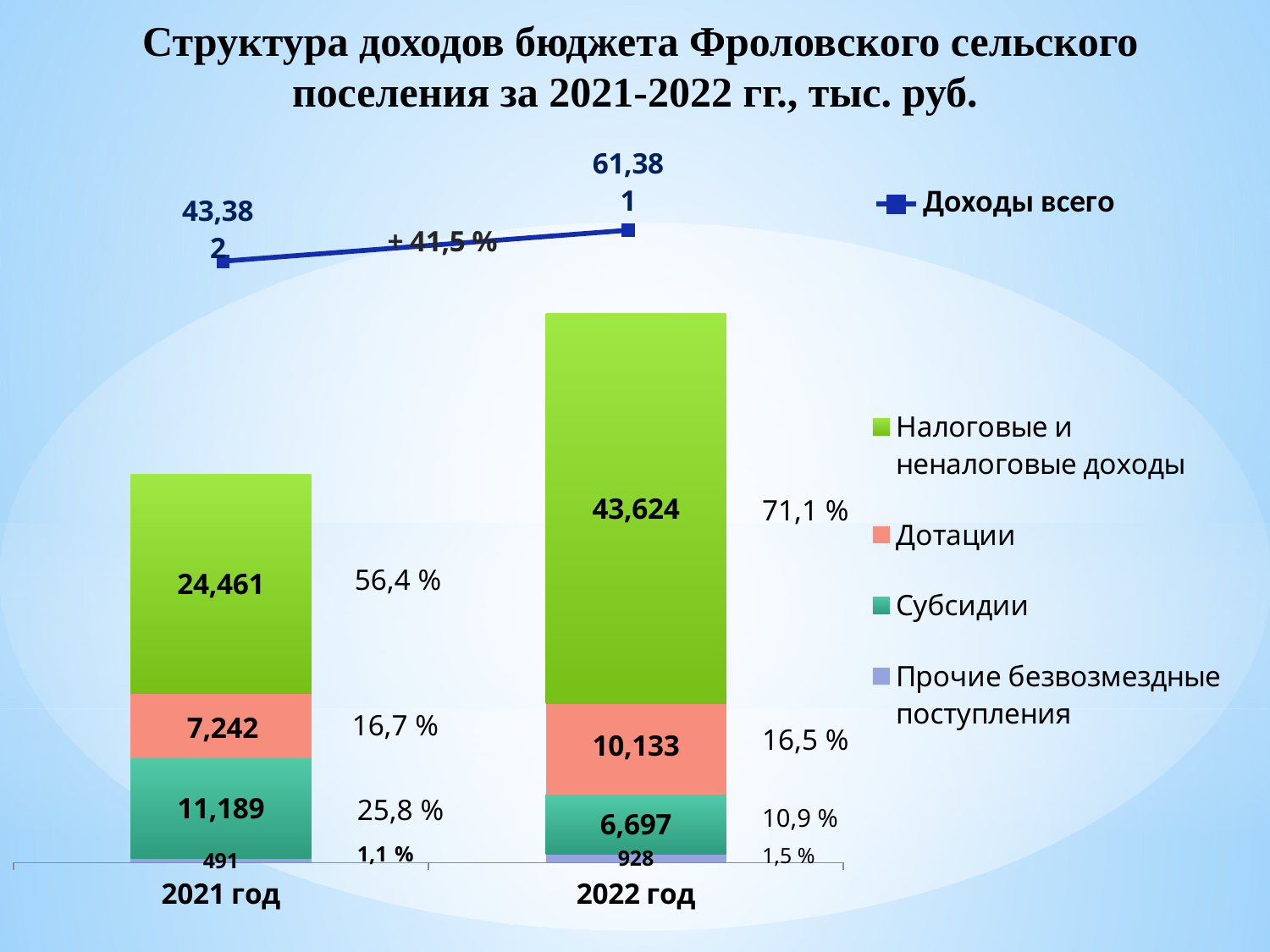
What is the value of Дотации for 2022 год? 10,133 By how much did Налоговые и неналоговые доходы increase from 2021 год to 2022 год? 19,163 Which component is the largest in the 2021 год bar? Налоговые и неналоговые доходы What percentage share is shown for Налоговые и неналоговые доходы in 2022 год? 71,1 % Is the value of Субсидии larger in 2021 год or in 2022 год? 2021 год What is the value of Субсидии for 2021 год? 11,189 How many years are shown on the x axis? 2 What is the value of Прочие безвозмездные поступления for 2022 год? 928 What percentage share is shown for Субсидии in 2021 год? 25,8 % Which component is the smallest in the 2022 год bar? Прочие безвозмездные поступления What is the value of Налоговые и неналоговые доходы for 2022 год? 43,624 What is the value of Налоговые и неналоговые доходы for 2021 год? 24,461